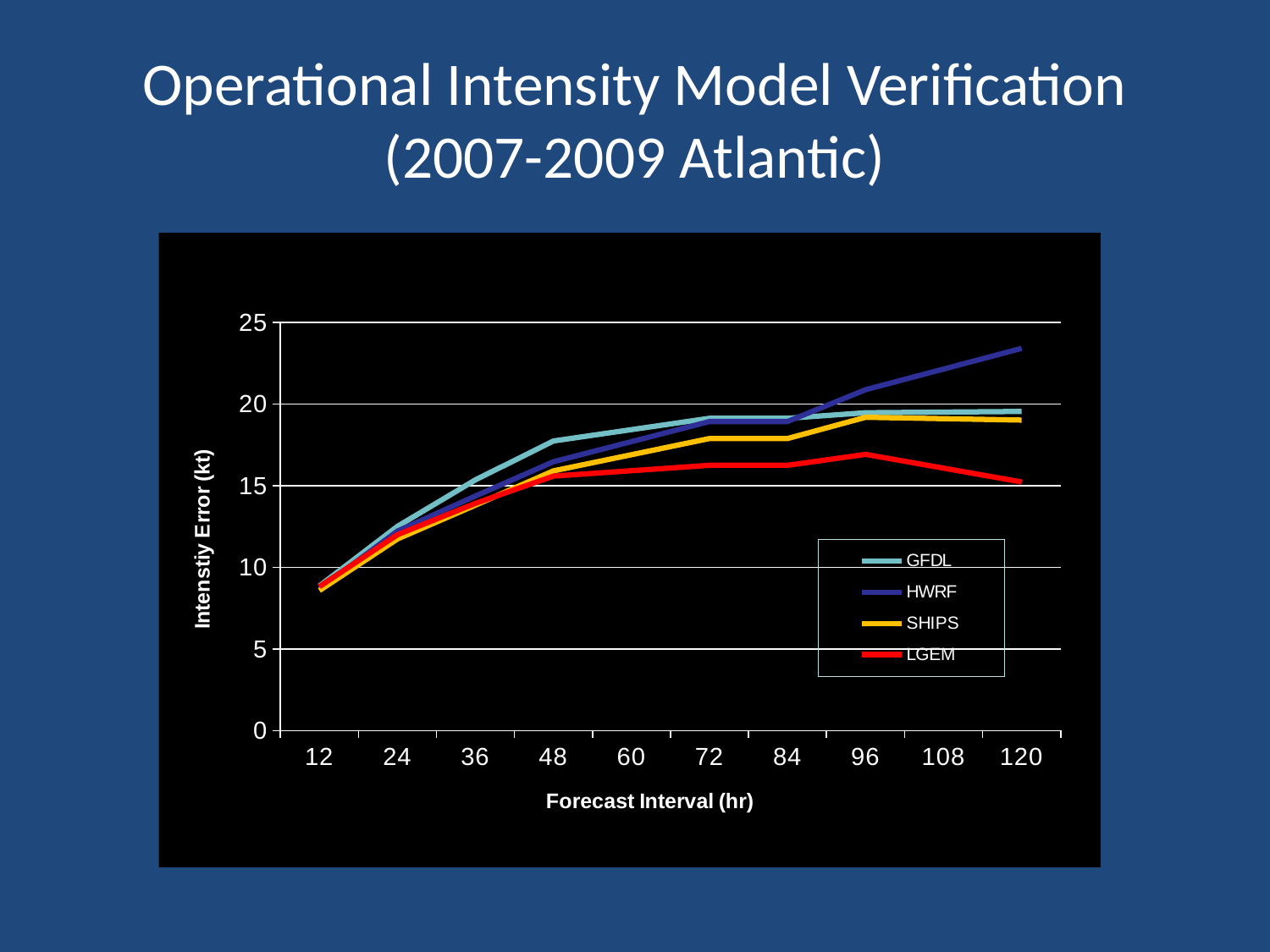
Which model has the lowest intensity error at 120 hr? LGEM What is the title of the x axis? Forecast Interval (hr) Is the LGEM intensity error at 12 hr greater or less than 10? less Which model has the highest intensity error at 120 hr? HWRF How many series does the legend list? 4 Does the HWRF intensity error rise or fall from 12 hr to 120 hr? rise What type of chart is shown on the slide? line chart Is the GFDL intensity error at 48 hr greater or less than 15? greater At 96 hr, which has the larger intensity error, HWRF or SHIPS? HWRF Is the LGEM intensity error at 120 hr greater or less than 20? less How many forecast intervals are plotted along the x axis? 10